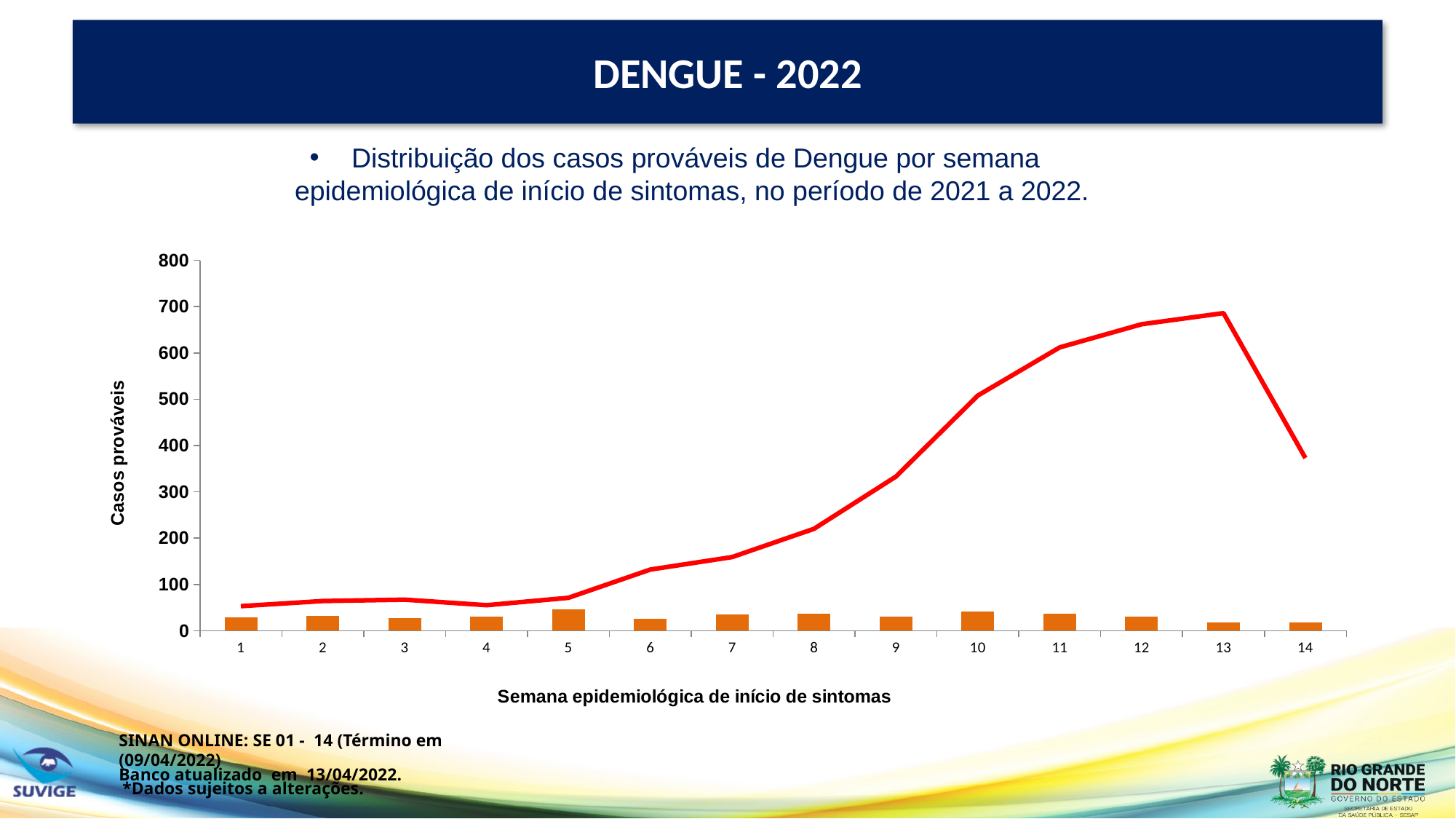
Does the red line rise or fall from week 1 to week 13? Rises Which is larger for the red line: the value in week 10 or the value in week 6? Week 10 Is the value of the red line in week 13 greater or less than 600? greater What is the label of the y axis? Casos prováveis In which week does the red line reach its highest value? 13 What is the label of the x axis? Semana epidemiológica de início de sintomas Is the value of the red line in week 14 greater or less than 300? greater What kind of chart is shown on the slide? A combined bar and line chart Is the value of the red line in week 11 greater or less than 500? greater How many epidemiological weeks are shown on the x axis? 14